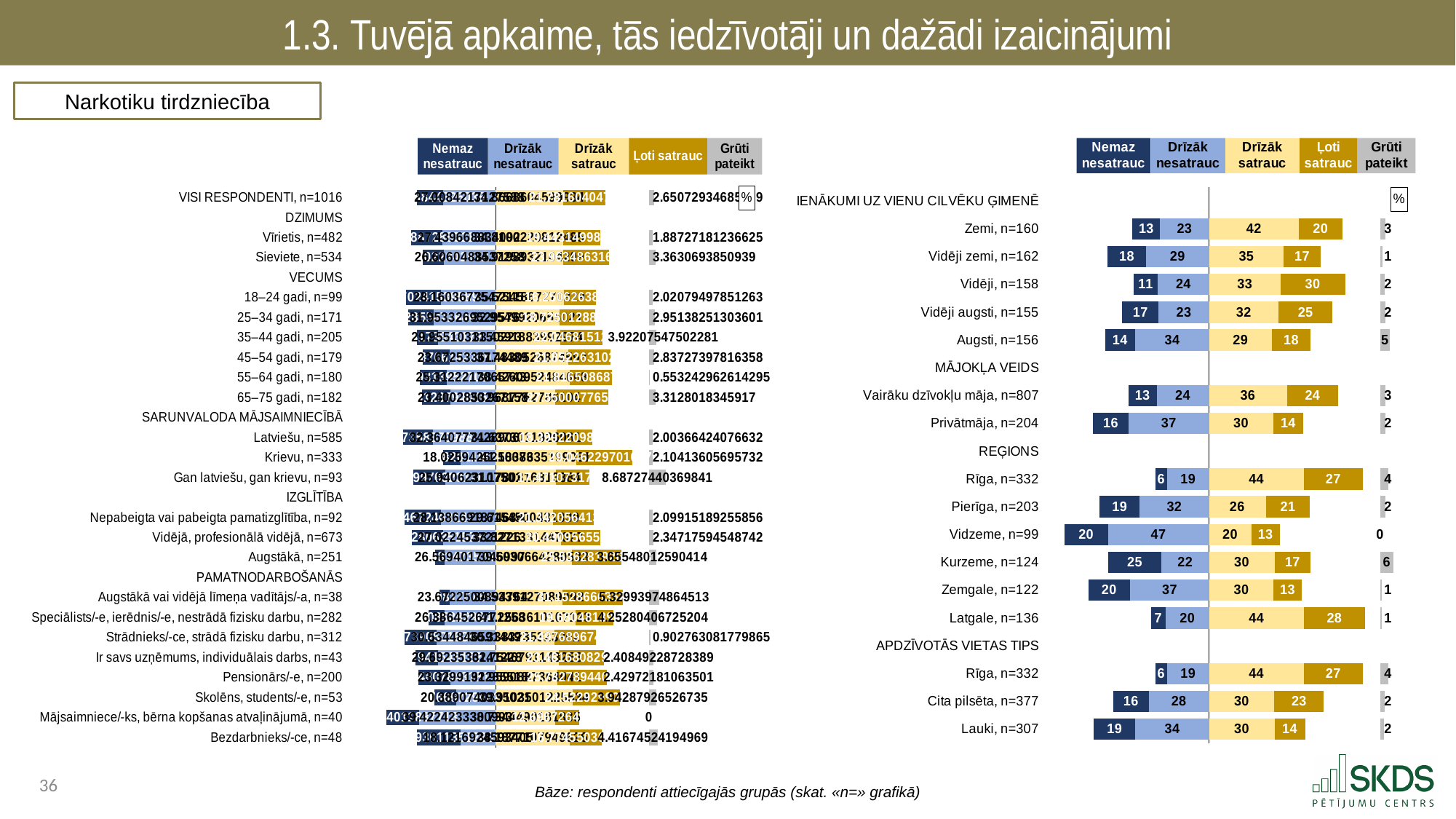
What kind of chart is the right-hand chart? Stacked horizontal bar chart In the right-hand chart, what is the value of 'Drīzāk nesatrauc' for 'Vidzeme, n=99'? 47 How many series does the legend of the right-hand chart list? 5 In the right-hand chart, which region under REĢIONS has the highest 'Ļoti satrauc' value? Latgale, n=136 In the right-hand chart, how many income groups are listed under IENĀKUMI UZ VIENU CILVĒKU ĢIMENĒ? 5 In the right-hand chart, what is the value of 'Drīzāk satrauc' for 'Zemi, n=160'? 42 In the right-hand chart, which region under REĢIONS has the lowest 'Nemaz nesatrauc' value? Rīga, n=332 In the right-hand chart, what is the value of 'Ļoti satrauc' for 'Vidēji, n=158'? 30 In the right-hand chart, what is the value of 'Grūti pateikt' for 'Kurzeme, n=124'? 6 In the right-hand chart, which has a larger 'Ļoti satrauc' value: 'Cita pilsēta, n=377' or 'Lauki, n=307'? Cita pilsēta, n=377 In the right-hand chart, what is the difference between the 'Drīzāk nesatrauc' values for 'Privātmāja, n=204' and 'Vairāku dzīvokļu māja, n=807'? 13 In the right-hand chart, which legend entry is shown in the darkest blue colour? Nemaz nesatrauc